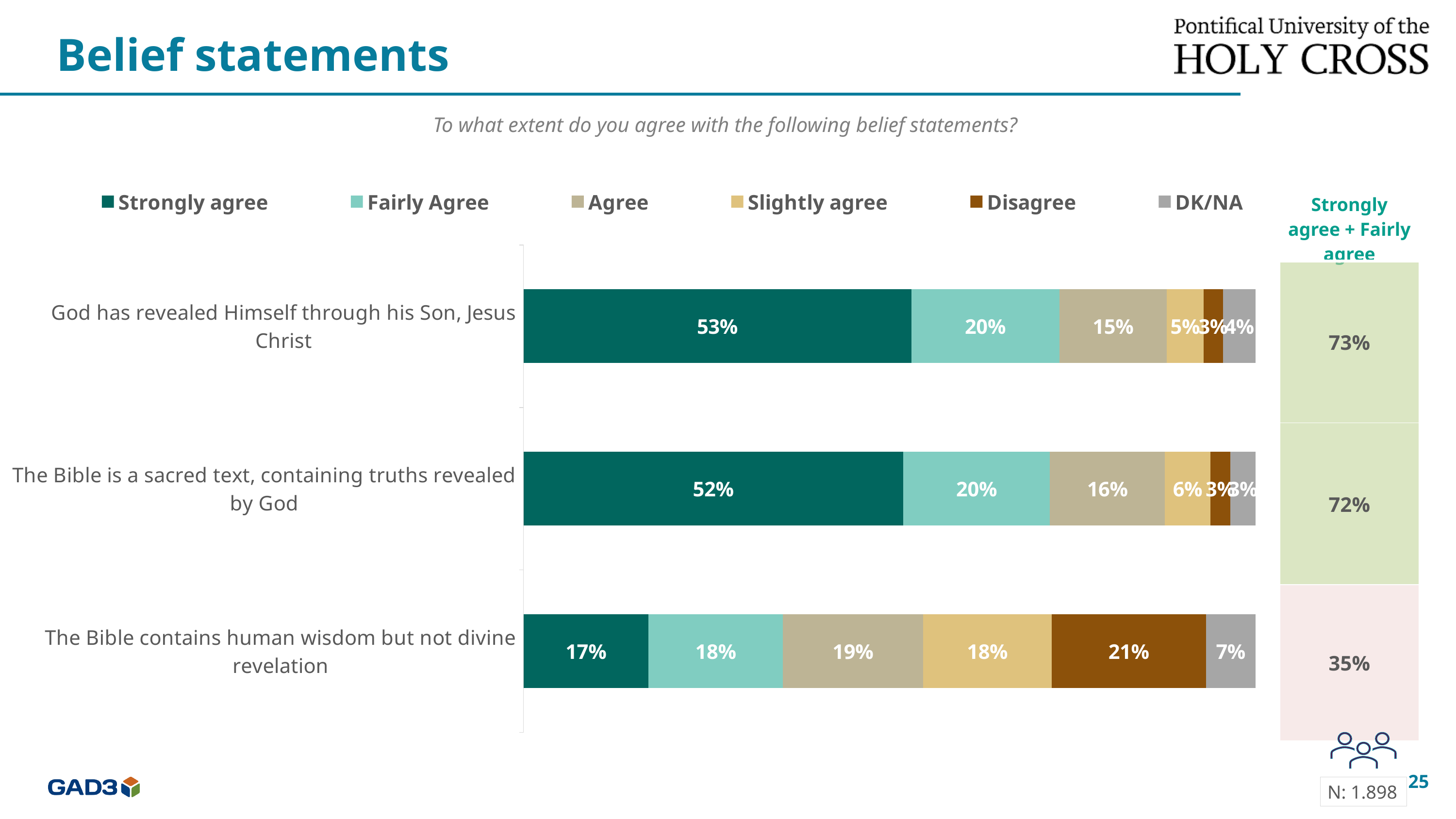
What kind of chart is shown on the slide? Stacked bar chart What is the DK/NA value for the statement 'The Bible contains human wisdom but not divine revelation'? 7% Which statement has the highest 'Strongly agree' value? God has revealed Himself through his Son, Jesus Christ What is the difference between the 'Strongly agree' values for 'God has revealed Himself through his Son, Jesus Christ' and 'The Bible contains human wisdom but not divine revelation'? 36% What percentage strongly agree that the Bible is a sacred text, containing truths revealed by God? 52% How many belief statements are plotted in the chart? 3 What percentage strongly agree that God has revealed Himself through his Son, Jesus Christ? 53% Which is larger: the 'Agree' value for 'The Bible is a sacred text, containing truths revealed by God' or the 'Agree' value for 'God has revealed Himself through his Son, Jesus Christ'? The Bible is a sacred text, containing truths revealed by God What is the combined 'Strongly agree + Fairly agree' value shown for 'The Bible contains human wisdom but not divine revelation'? 35% Which statement has the lowest 'Strongly agree' value? The Bible contains human wisdom but not divine revelation What percentage disagree that the Bible contains human wisdom but not divine revelation? 21% How many series does the legend list? 6